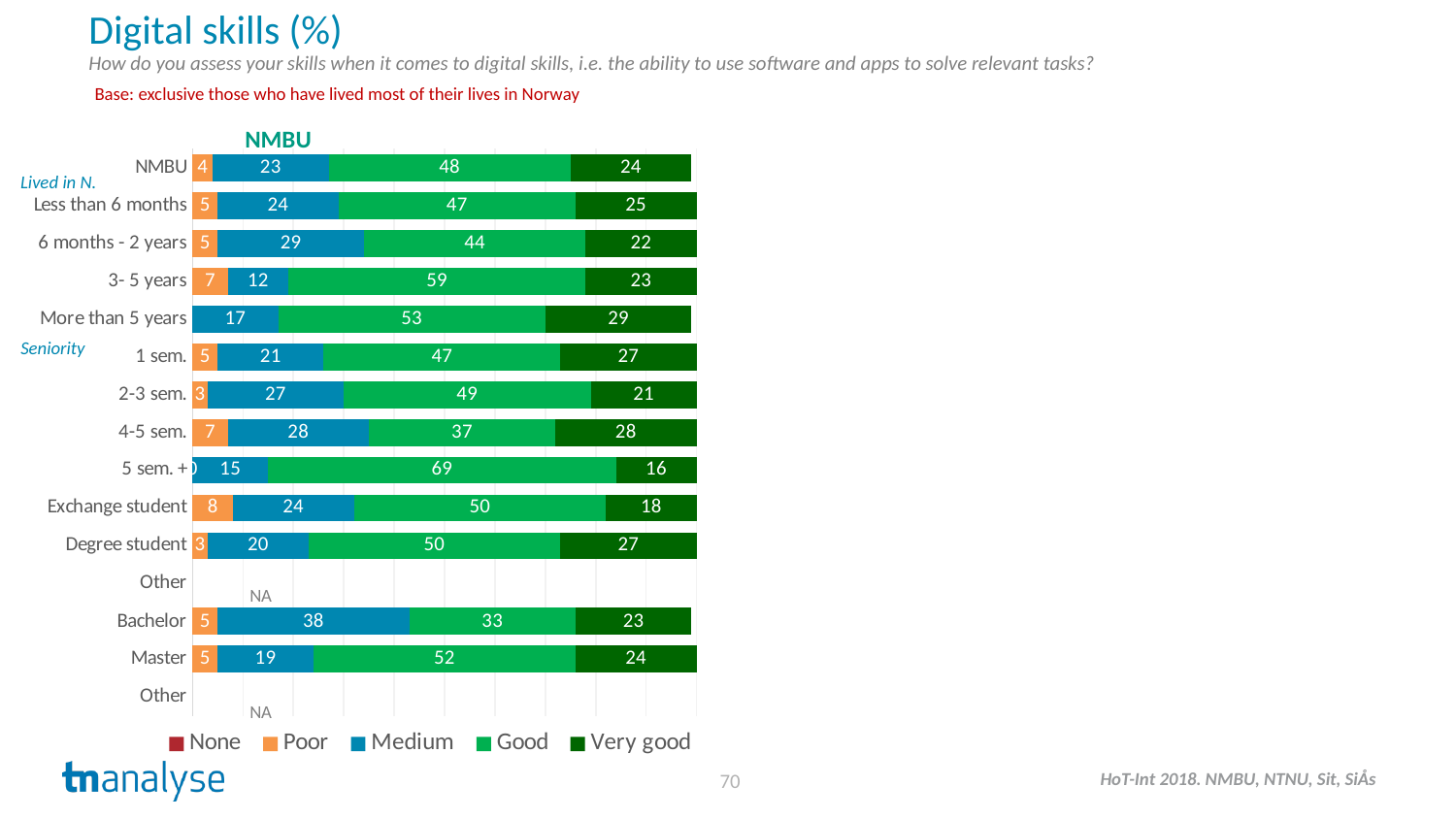
Which has the larger Medium value, Bachelor or Master? Bachelor What is the Very good value for More than 5 years? 29 Which category label is shown with NA instead of a bar? Other What kind of chart is shown on the slide? Stacked bar chart What is the Poor value for Exchange student? 8 How many series does the legend list? 5 Which category has the highest Good value? 5 sem. + What is the Medium value for Bachelor? 38 What is the difference between the Good value for 3- 5 years and the Good value for 6 months - 2 years? 15 Which category has the lowest Good value? Bachelor What is the total of the printed values in the Master bar? 100 What is the value for Good for the NMBU category? 48